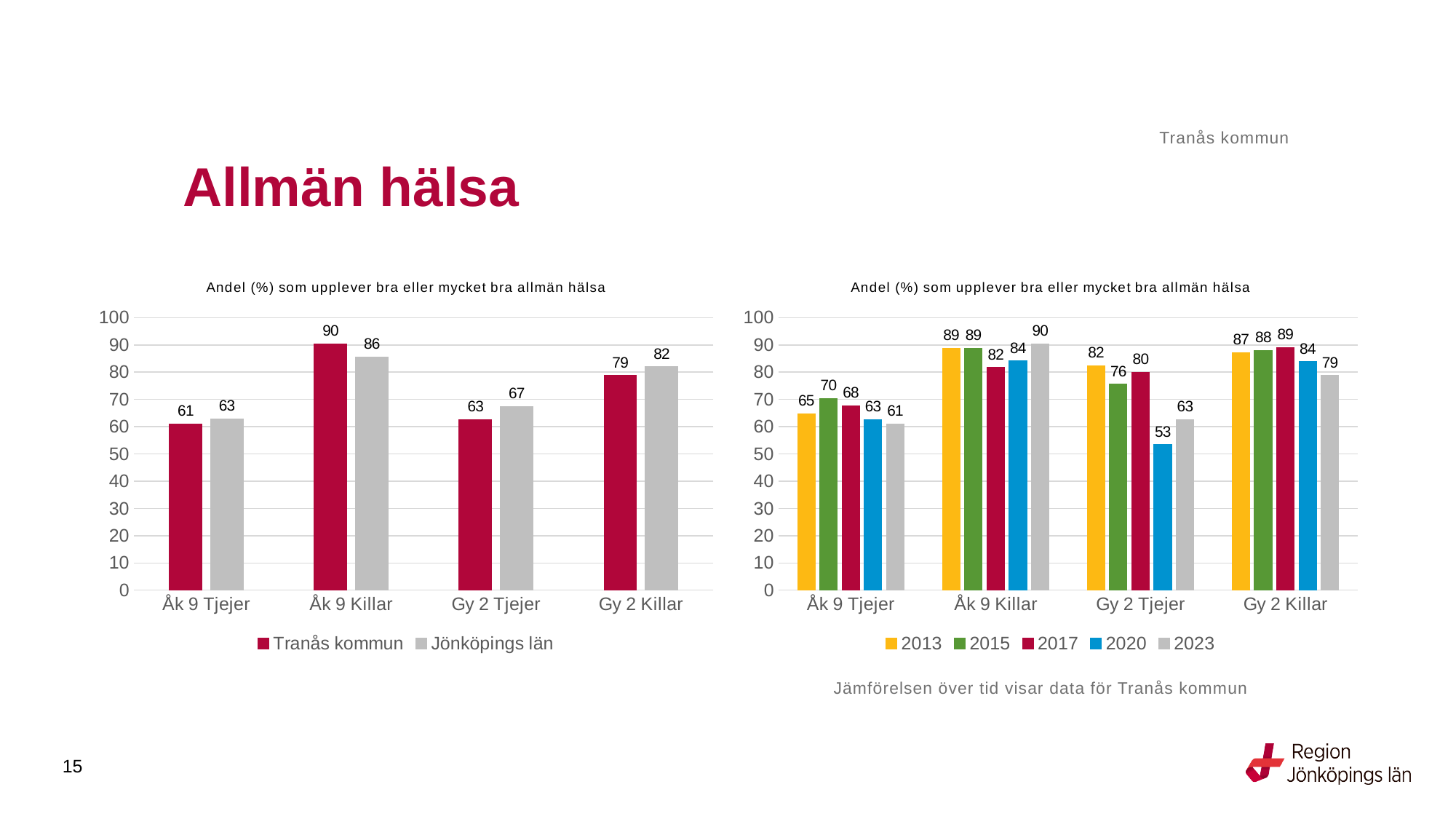
In the left chart, what is the value for Jönköpings län for Gy 2 Tjejer? 67 In the right chart, what is the value for 2020 for Gy 2 Tjejer? 53 In the right chart, which is larger for Åk 9 Tjejer: the value for 2015 or the value for 2023? 2015 In the right chart, which year has the highest value for Gy 2 Killar? 2017 In the right chart, how many series does the legend list? 5 In the right chart, what is the value for 2023 for Åk 9 Killar? 90 In the right chart, what is the difference between the 2013 and 2020 values for Gy 2 Tjejer? 29 In the left chart, what is the value for Tranås kommun for Åk 9 Killar? 90 What type of chart is the left chart? Bar chart In the left chart, which category has the lowest value for Tranås kommun? Åk 9 Tjejer In the left chart, what is the difference between Jönköpings län and Tranås kommun for Åk 9 Killar? 4 In the left chart, how many series does the legend list? 2